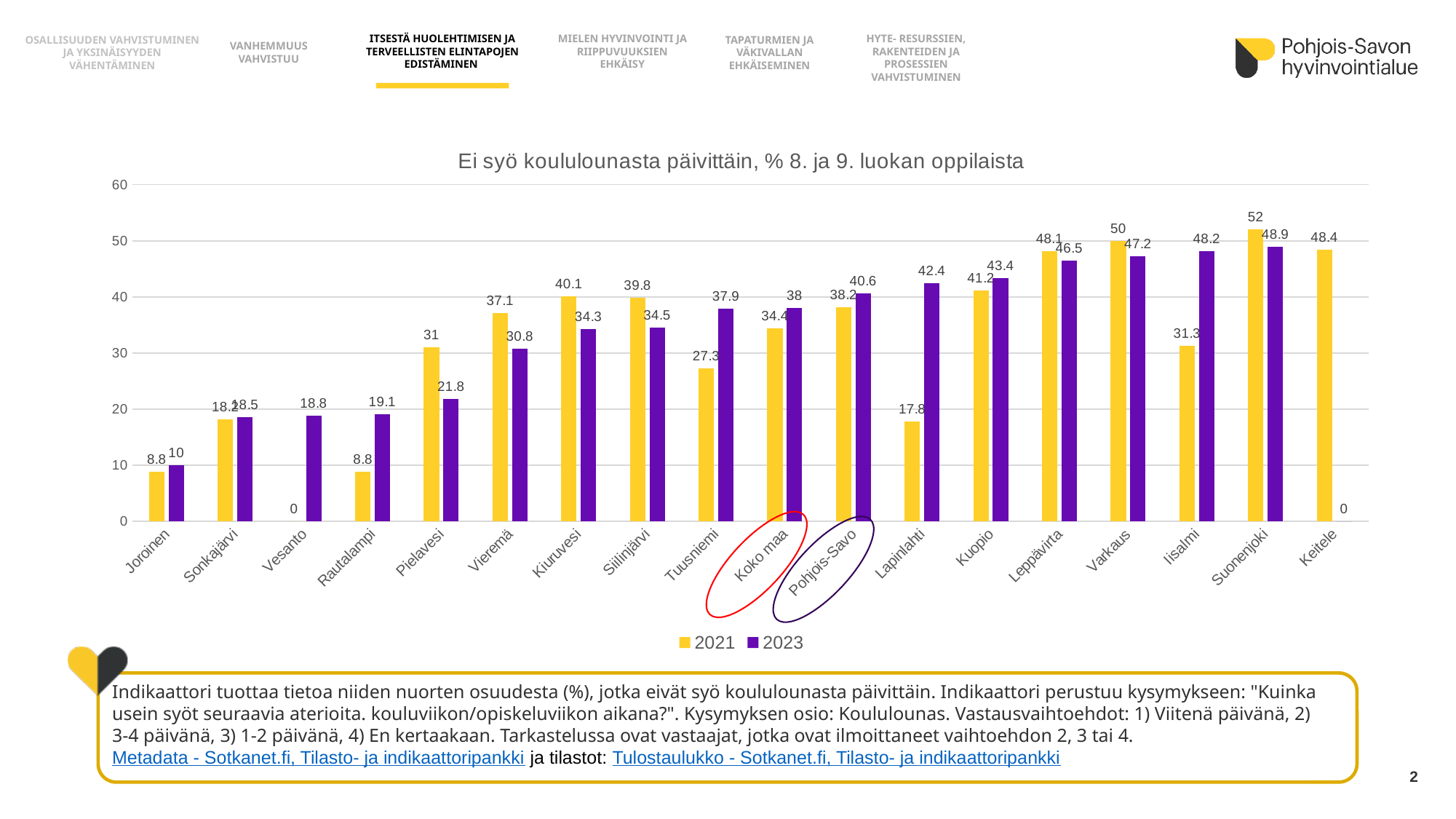
What is the difference between the 2021 and 2023 values for Varkaus? 2.8 Which category has the lowest 2021 value? Vesanto What is the 2021 value for Pohjois-Savo? 38.2 What is the title of the chart? Ei syö koululounasta päivittäin, % 8. ja 9. luokan oppilaista What is the difference between the 2023 and 2021 values for Lapinlahti? 24.6 What kind of chart is shown on the slide? Bar chart Which category has the highest 2021 value? Suonenjoki How many categories are shown on the x axis? 18 How many series does the legend list? 2 What is the 2023 value for Lapinlahti? 42.4 Which is larger for Pielavesi, the 2021 value or the 2023 value? 2021 What is the 2023 value for Koko maa? 38